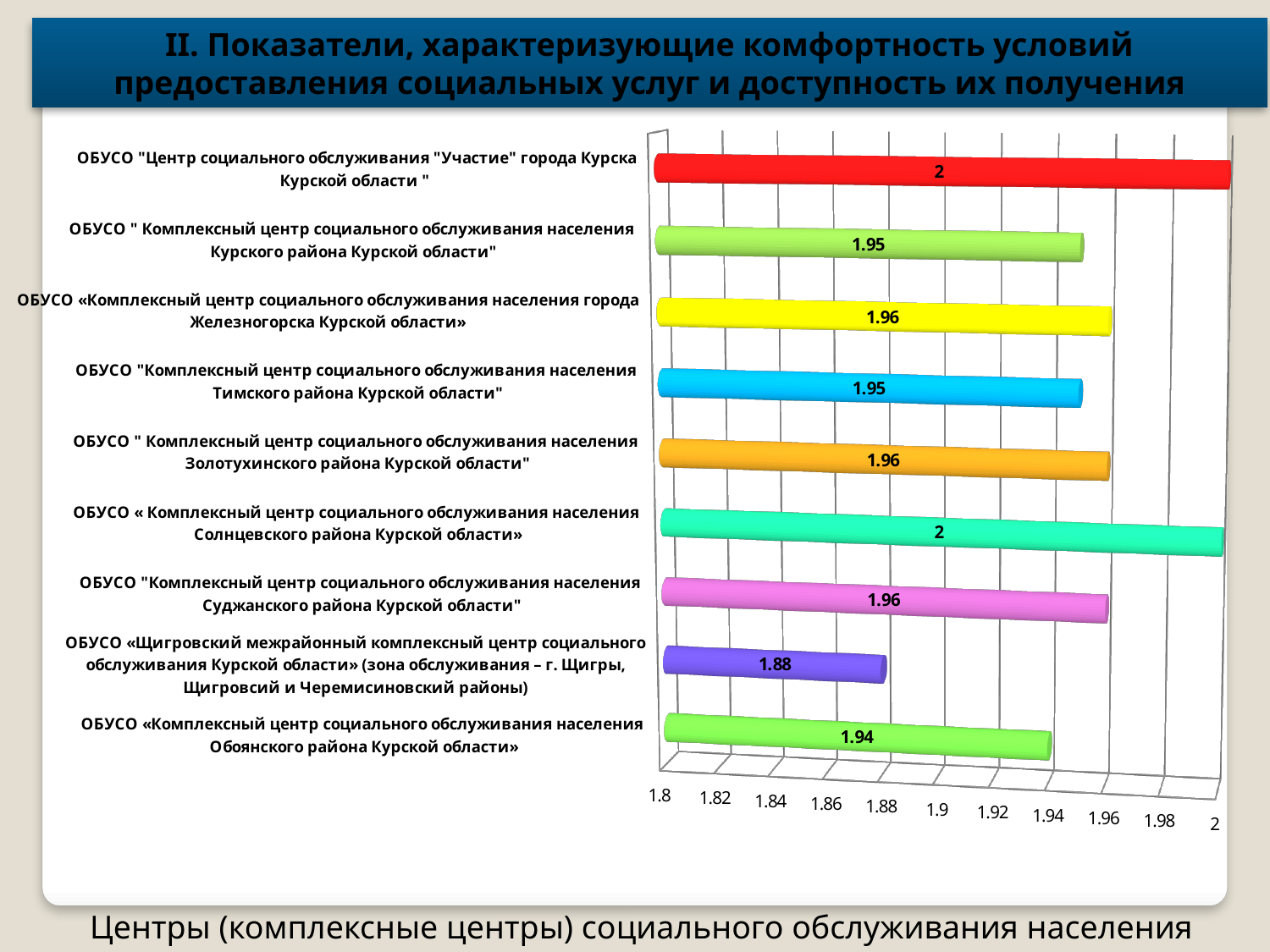
What is the difference between the value for the Солнцевского района centre and the Щигровский межрайонный centre? 0.12 What kind of chart is shown on the slide? Bar chart What is the value for ОБУСО "Комплексный центр социального обслуживания населения Тимского района Курской области"? 1.95 What is the difference between the value for the Суджанского района centre and the Обоянского района centre? 0.02 Which organisation has the lowest value on the chart? ОБУСО «Щигровский межрайонный комплексный центр социального обслуживания Курской области» What is the value for ОБУСО «Комплексный центр социального обслуживания населения Обоянского района Курской области»? 1.94 Which has a larger value: the Золотухинского района centre or the Курского района centre? Золотухинского района centre What is the value for ОБУСО "Центр социального обслуживания "Участие" города Курска Курской области"? 2 How many organisations (bars) are shown on the chart? 9 What is the value for ОБУСО «Комплексный центр социального обслуживания населения города Железногорска Курской области»? 1.96 What is the value for ОБУСО «Щигровский межрайонный комплексный центр социального обслуживания Курской области»? 1.88 Is the value for the Щигровский межрайонный centre greater or less than 1.9? less